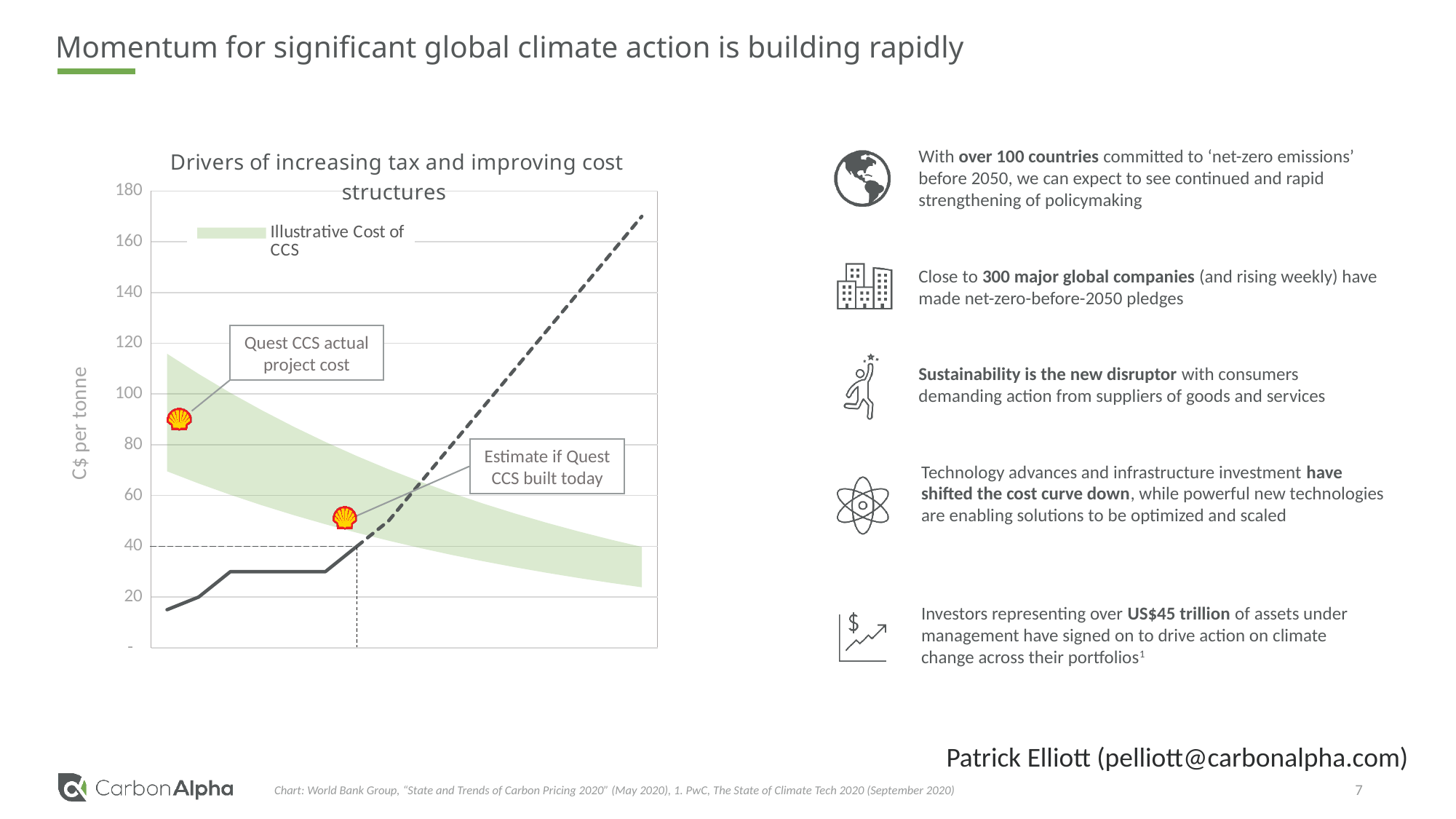
Does the dark line in the chart rise or fall from left to right? rise Does the green 'Illustrative Cost of CCS' band rise or fall from left to right? fall Is the value at the right-hand end of the dashed line greater or less than 160? greater What kind of chart is shown on the slide? combination area and line chart What is the single entry shown in the chart's legend? Illustrative Cost of CCS How many Shell-logo markers are plotted on the chart? 2 Is the value at the left-hand start of the dark solid line greater or less than 20? less What is the label on the vertical axis of the chart? C$ per tonne Which is larger: the 'Quest CCS actual project cost' or the 'Estimate if Quest CCS built today'? Quest CCS actual project cost Is the value marked as 'Quest CCS actual project cost' greater or less than 80? greater What is the title of the chart on the slide? Drivers of increasing tax and improving cost structures